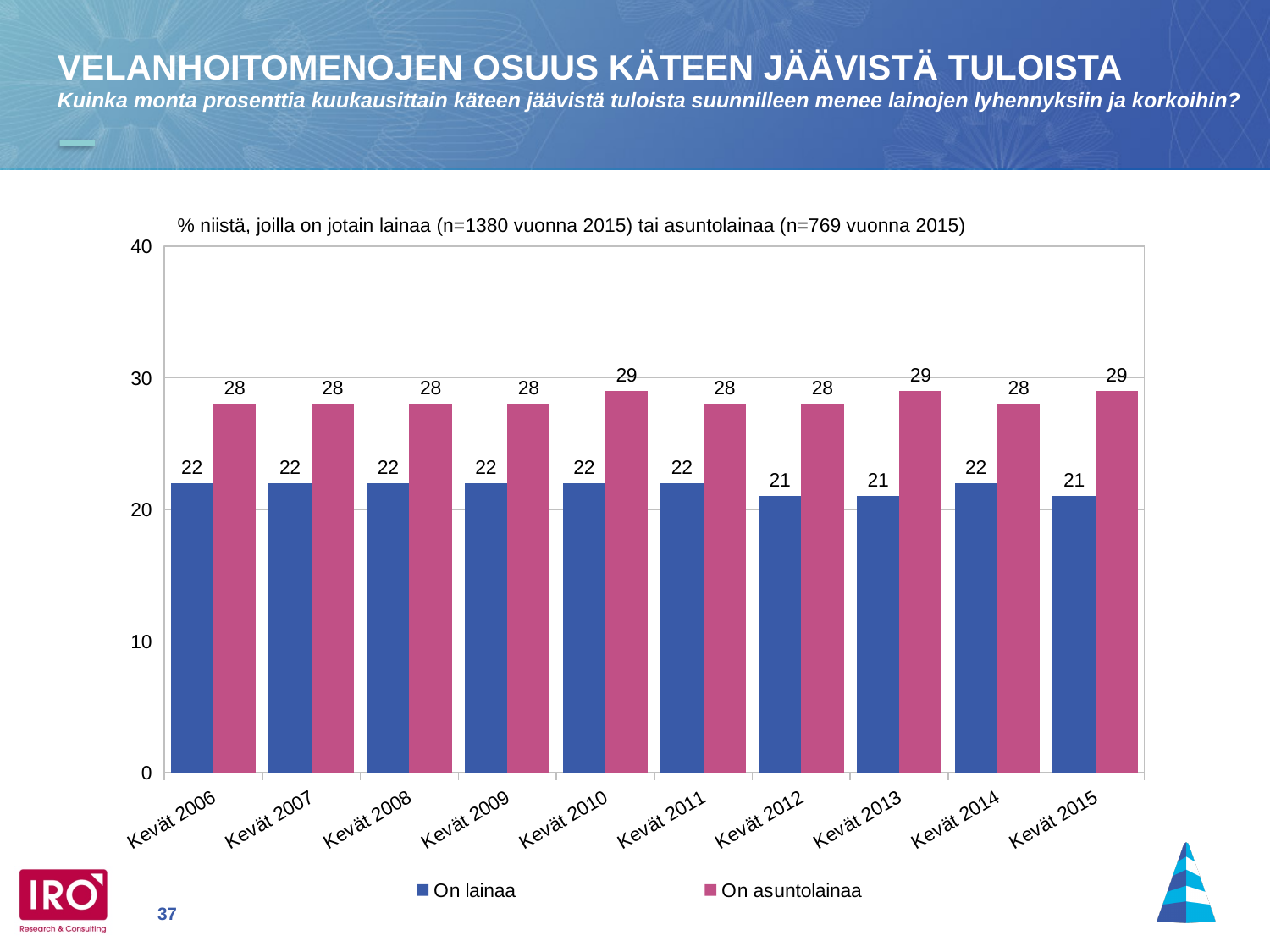
What is the value for "On lainaa" in Kevät 2015? 21 What kind of chart is shown on the slide? Bar chart What is the value for "On asuntolainaa" in Kevät 2010? 29 What is the value for "On lainaa" in Kevät 2012? 21 How many categories are shown on the x axis? 10 What colour are the bars for the "On asuntolainaa" series? Pink Is the value for "On asuntolainaa" in Kevät 2011 greater or less than 30? less How many series does the legend list? 2 What is the difference between "On asuntolainaa" and "On lainaa" in Kevät 2015? 8 What is the difference between "On asuntolainaa" and "On lainaa" in Kevät 2006? 6 What is the value for "On asuntolainaa" in Kevät 2006? 28 Which series has the larger value in Kevät 2013, "On lainaa" or "On asuntolainaa"? On asuntolainaa